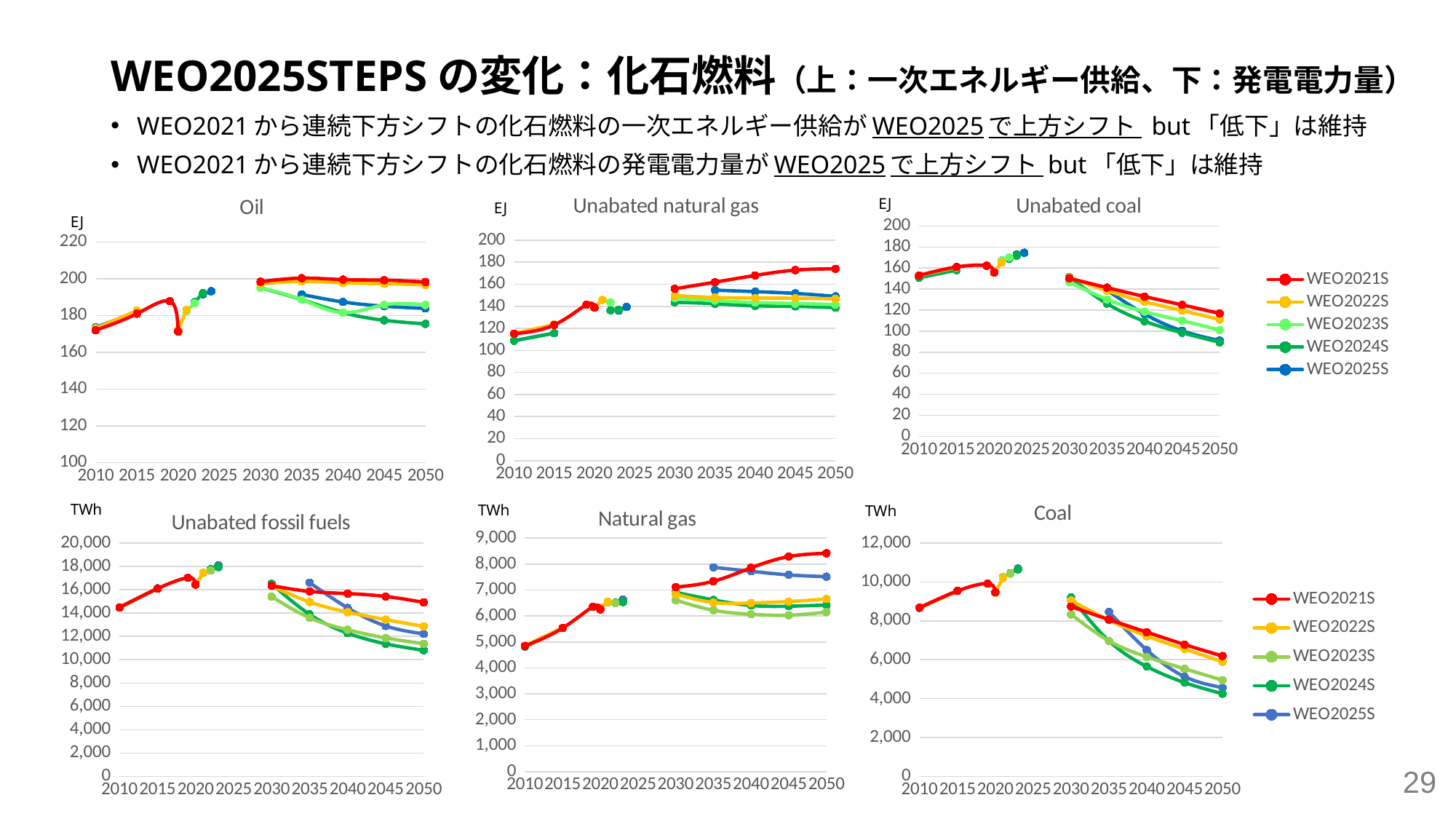
In the 'Natural gas' chart (bottom middle), which is larger in 2050: WEO2021S or WEO2023S? WEO2021S In the 'Unabated fossil fuels' chart, which series is highest in 2050? WEO2021S In the 'Oil' chart, is the WEO2021S value in 2050 greater or less than 180? greater In the 'Unabated coal' chart, does the WEO2025S line rise or fall from 2030 to 2050? fall In the 'Unabated natural gas' chart, is the WEO2025S value in 2050 greater or less than 160? less What kind of chart is the 'Oil' chart? Line chart What unit is shown on the y-axis of the 'Oil' chart? EJ In the 'Natural gas' chart (bottom middle), does the WEO2021S line rise or fall from 2030 to 2050? rise In the 'Unabated coal' chart, is the WEO2024S value in 2050 greater or less than 100? less How many series does the legend next to the 'Unabated coal' chart list? 5 In the 'Unabated natural gas' chart, which is larger in 2050: WEO2021S or WEO2024S? WEO2021S